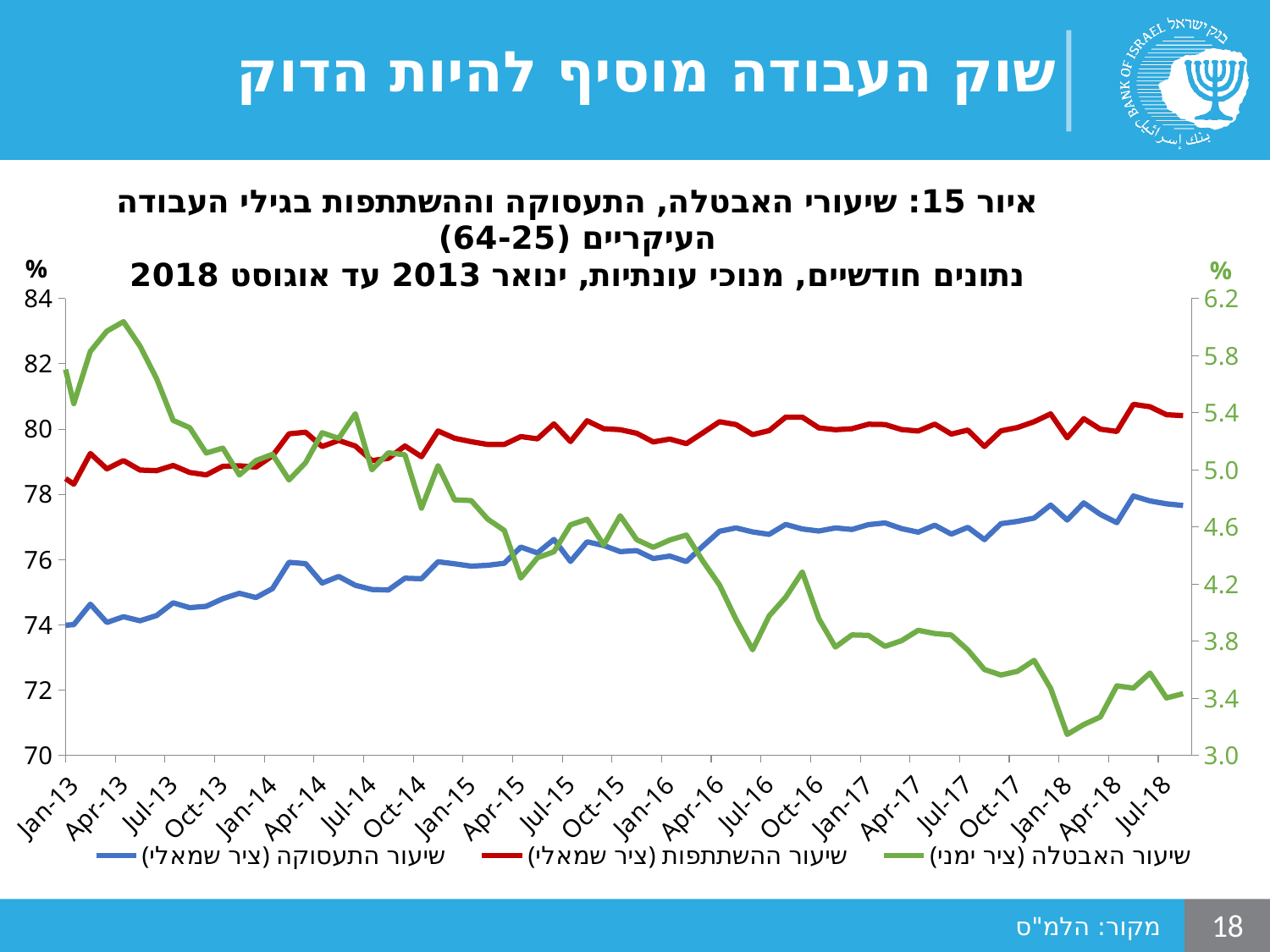
What is the figure number given in the chart title? איור 15 Is the employment rate (blue line) at Jul-18 greater or less than 76? greater Which axis does the unemployment rate series (שיעור האבטלה) use, according to the legend? right axis (ציר ימני) What kind of chart is shown on the slide? line chart Does the employment rate (שיעור התעסוקה, blue line) rise or fall from Jan-13 to Jul-18? rise At Jan-13, which is higher on the left axis: the employment rate (blue) or the participation rate (red)? participation rate (red) Is the unemployment rate (green line, right axis) at Jan-13 greater or less than 5.0? greater Is the unemployment rate (green line, right axis) at Jul-18 greater or less than 3.8? less How many series does the legend list? 3 Does the unemployment rate (שיעור האבטלה, green line) rise or fall from Jan-13 to Jul-18? fall